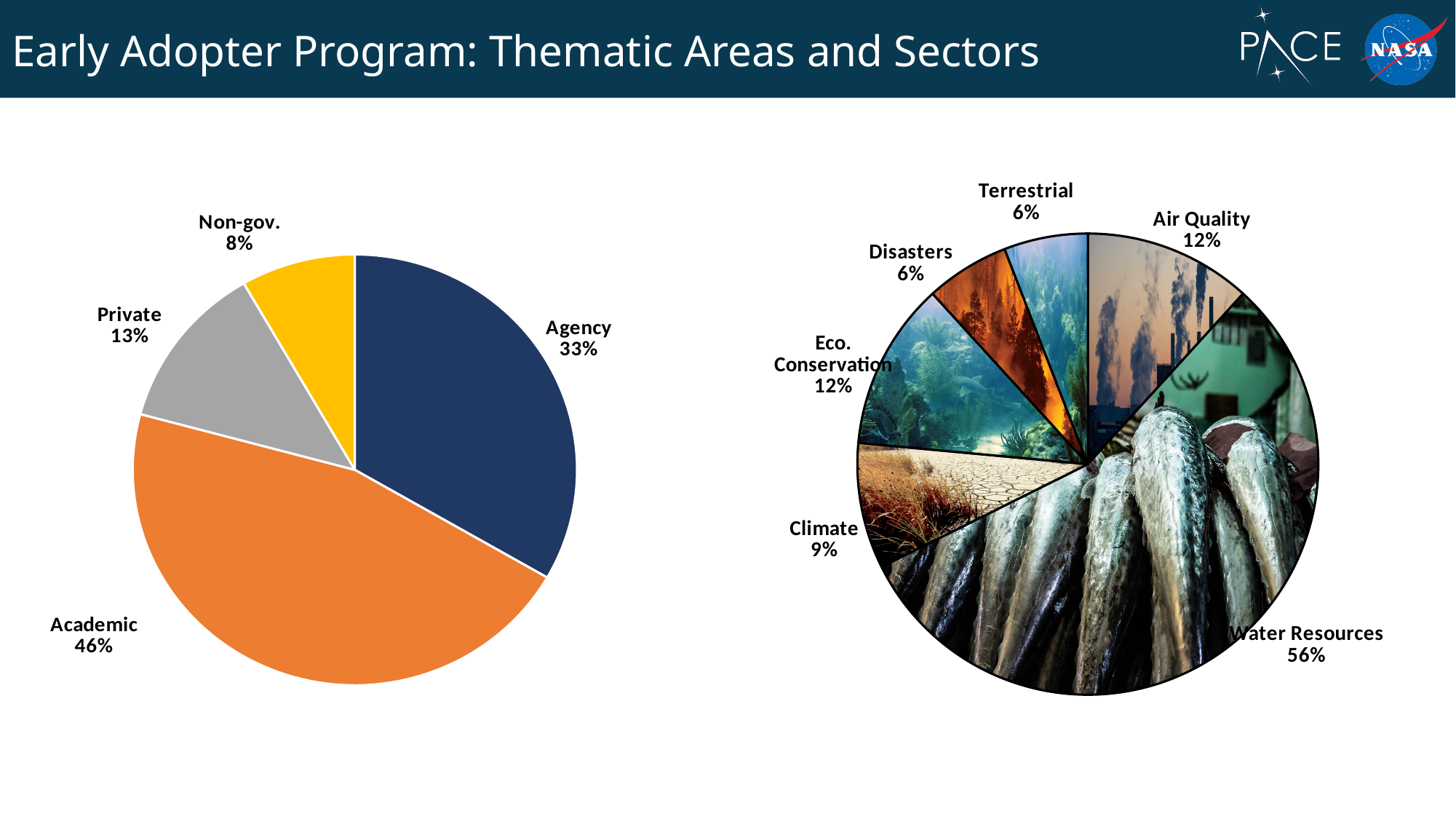
In the left pie chart (sectors), what is the difference between the Academic and Agency shares? 13% In the right pie chart (thematic areas), what share does Climate have? 9% In the right pie chart (thematic areas), how many thematic areas are shown? 6 In the left pie chart (sectors), which sector has the smallest share? Non-gov. In the left pie chart (sectors), how many sectors are shown? 4 In the left pie chart (sectors), what share does Non-gov. have? 8% In the right pie chart (thematic areas), which is larger, Air Quality or Climate? Air Quality In the left pie chart (sectors), which sector has the largest share? Academic In the right pie chart (thematic areas), what share does Water Resources have? 56% What type of chart is used on the left side of the slide? Pie chart In the left pie chart (sectors), what share does Academic have? 46% In the right pie chart (thematic areas), which thematic area has the largest share? Water Resources